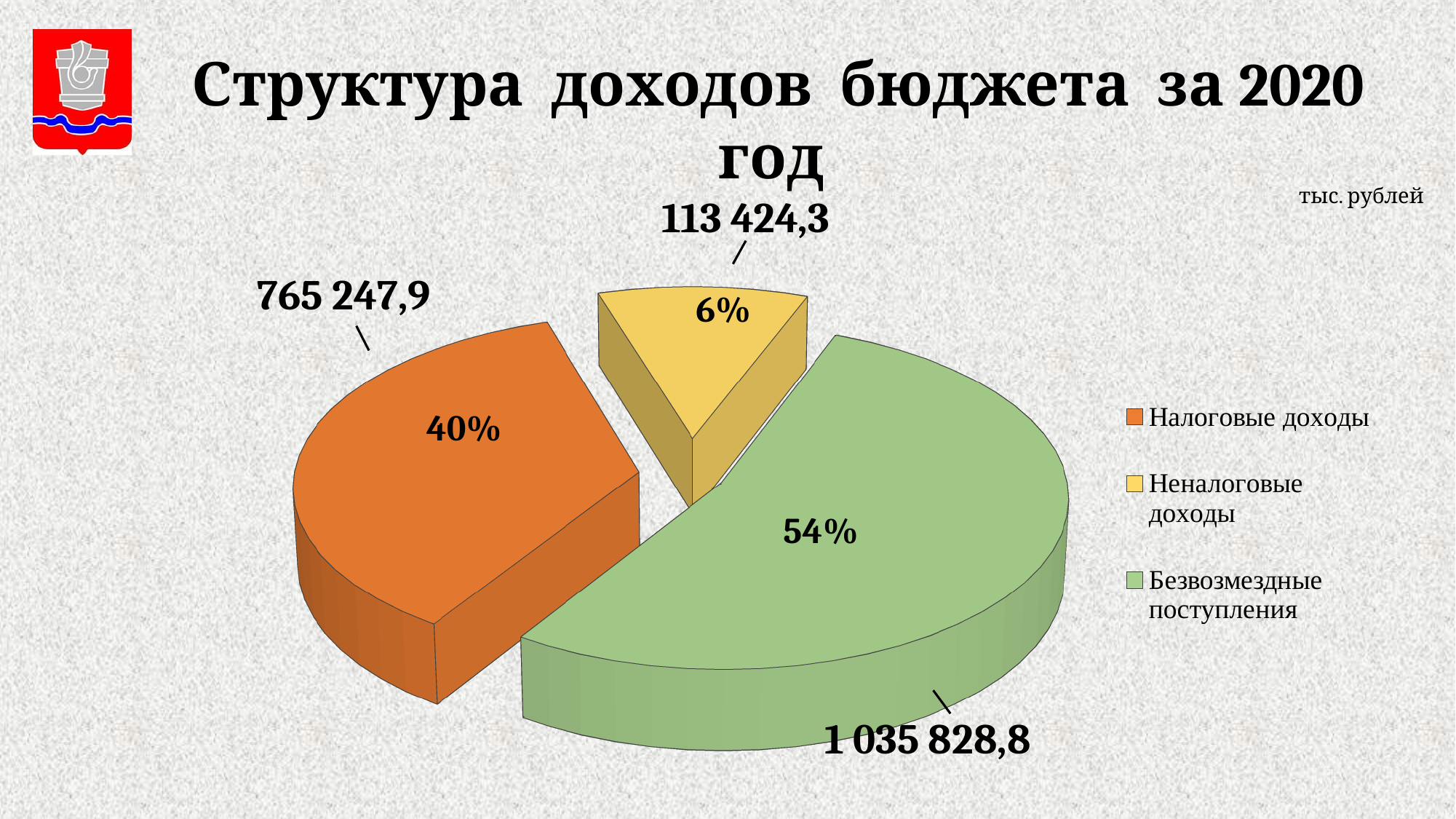
What is the difference between the values for Безвозмездные поступления and Налоговые доходы? 270 580,9 What share of the pie does Безвозмездные поступления represent? 54% What unit is indicated for the values on the chart? тыс. рублей How many categories does the pie chart have? 3 Which category has the smallest value? Неналоговые доходы What is the value for Безвозмездные поступления? 1 035 828,8 What share of the pie does Налоговые доходы represent? 40% What is the value for Налоговые доходы? 765 247,9 What share of the pie does Неналоговые доходы represent? 6% What kind of chart is shown on the slide? Pie chart Which category has the largest value? Безвозмездные поступления What is the value for Неналоговые доходы? 113 424,3